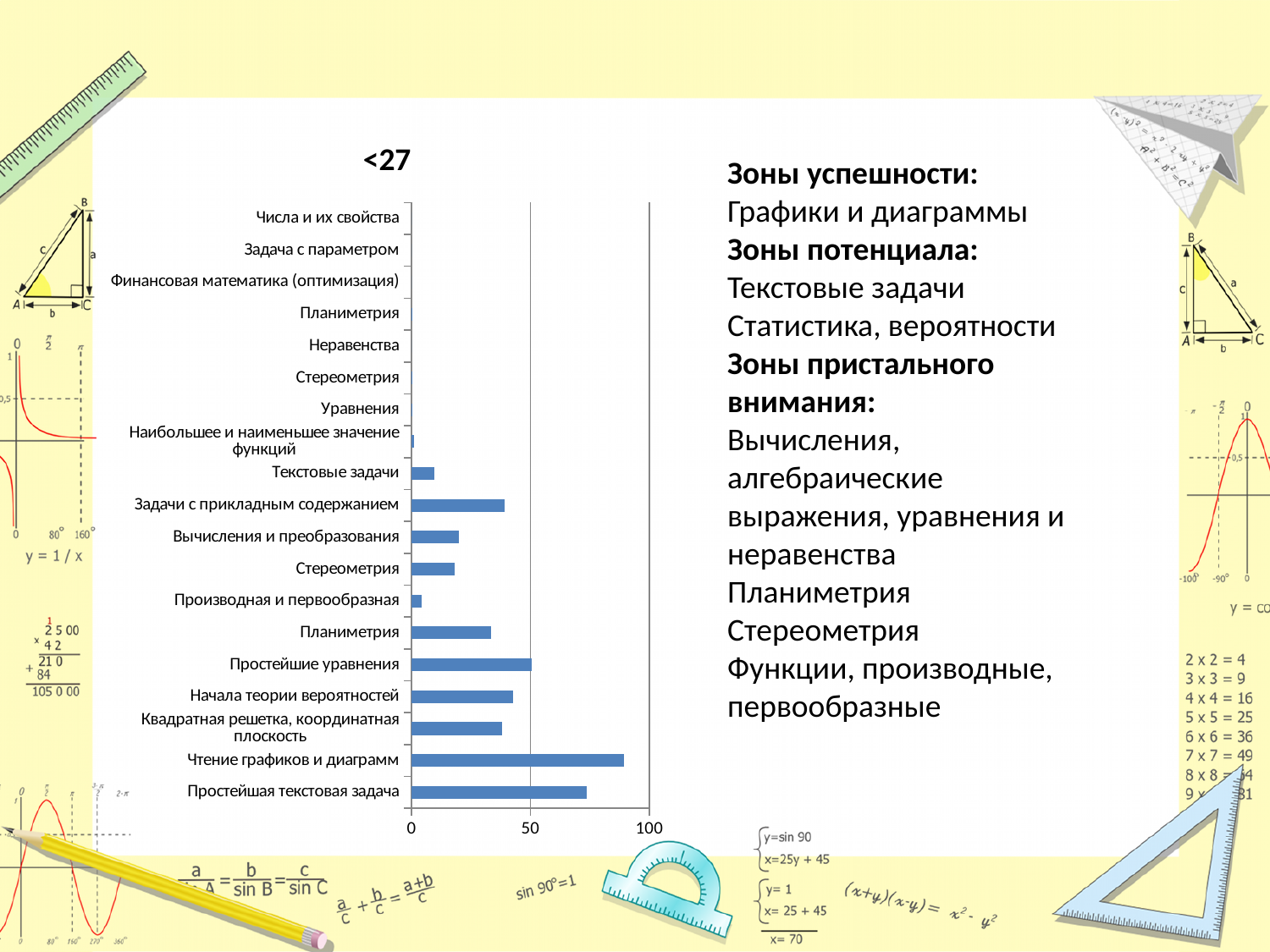
Is the value for Простейшая текстовая задача greater or less than 50? greater What is the title of the chart? <27 Which category has the highest value in the chart? Чтение графиков и диаграмм Is the value for Чтение графиков и диаграмм greater or less than 50? greater Which is larger: the value for Чтение графиков и диаграмм or the value for Простейшая текстовая задача? Чтение графиков и диаграмм Is the value for Начала теории вероятностей greater or less than 50? less What is the highest value shown on the horizontal axis of the chart? 100 What kind of chart is shown on the slide? bar chart Which is larger: the value for Простейшие уравнения or the value for Текстовые задачи? Простейшие уравнения How many categories are plotted in the chart? 19